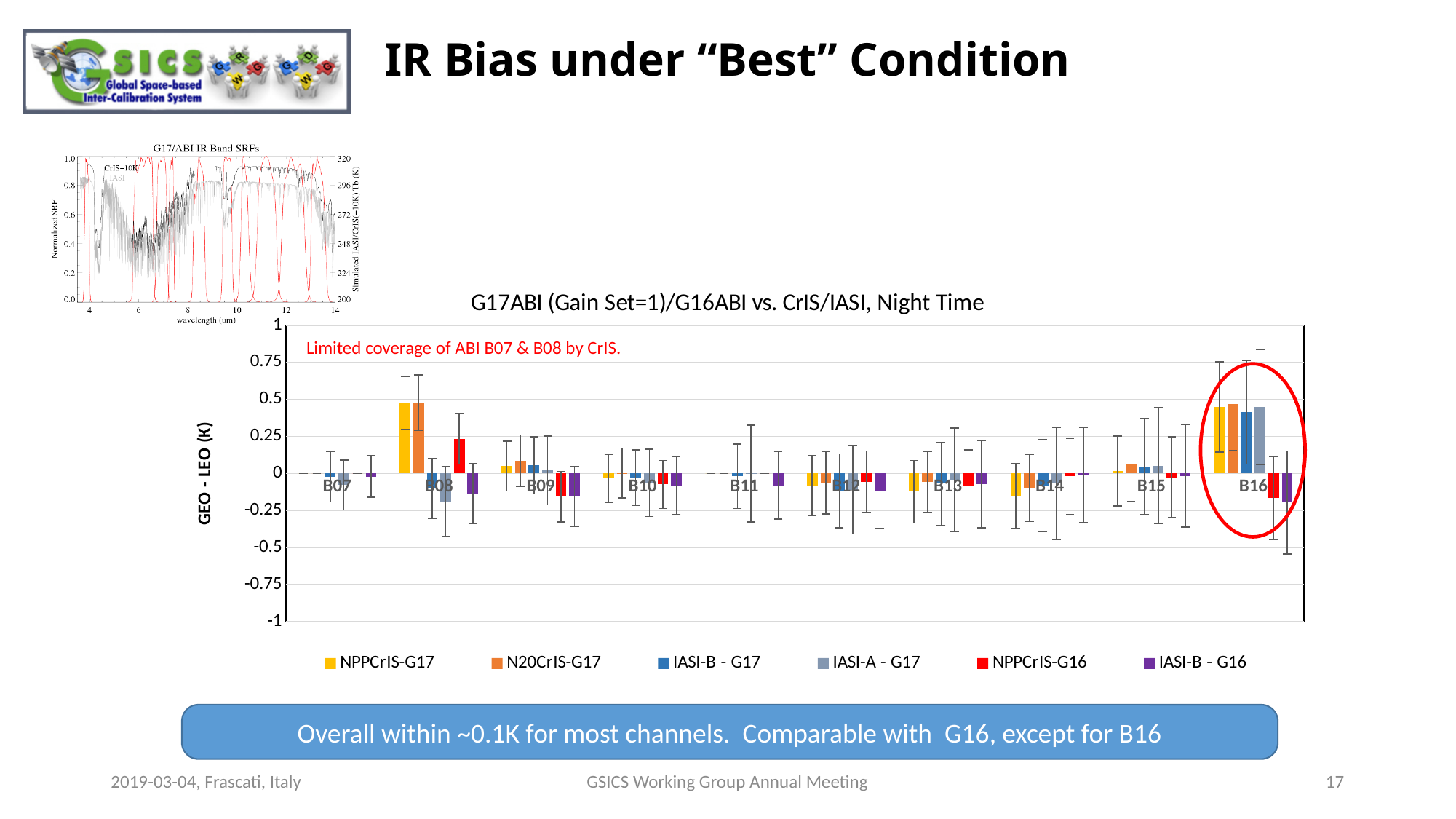
In the "G17ABI (Gain Set=1)/G16ABI vs. CrIS/IASI, Night Time" chart, what is the label of the y axis? GEO - LEO (K) In the "G17ABI (Gain Set=1)/G16ABI vs. CrIS/IASI, Night Time" chart, how many band categories are shown on the x axis? 10 In the "G17ABI (Gain Set=1)/G16ABI vs. CrIS/IASI, Night Time" chart, is the NPPCrIS-G16 value for B16 greater or less than 0? less What is the title of the small chart in the top-left of the slide? G17/ABI IR Band SRFs In the "G17ABI (Gain Set=1)/G16ABI vs. CrIS/IASI, Night Time" chart, is the N20CrIS-G17 value for B16 greater or less than 0.25? greater In the "G17ABI (Gain Set=1)/G16ABI vs. CrIS/IASI, Night Time" chart, is the IASI-A - G17 value for B08 greater or less than 0? less In the "G17ABI (Gain Set=1)/G16ABI vs. CrIS/IASI, Night Time" chart, which is larger for B16: the IASI-B - G17 value or the IASI-B - G16 value? IASI-B - G17 What kind of chart is the small chart titled "G17/ABI IR Band SRFs" in the top-left of the slide? line chart In the "G17ABI (Gain Set=1)/G16ABI vs. CrIS/IASI, Night Time" chart, which is larger for B08: the NPPCrIS-G17 value or the NPPCrIS-G16 value? NPPCrIS-G17 In the "G17ABI (Gain Set=1)/G16ABI vs. CrIS/IASI, Night Time" chart, how many series does the legend list? 6 What kind of chart is the large chart titled "G17ABI (Gain Set=1)/G16ABI vs. CrIS/IASI, Night Time"? bar chart